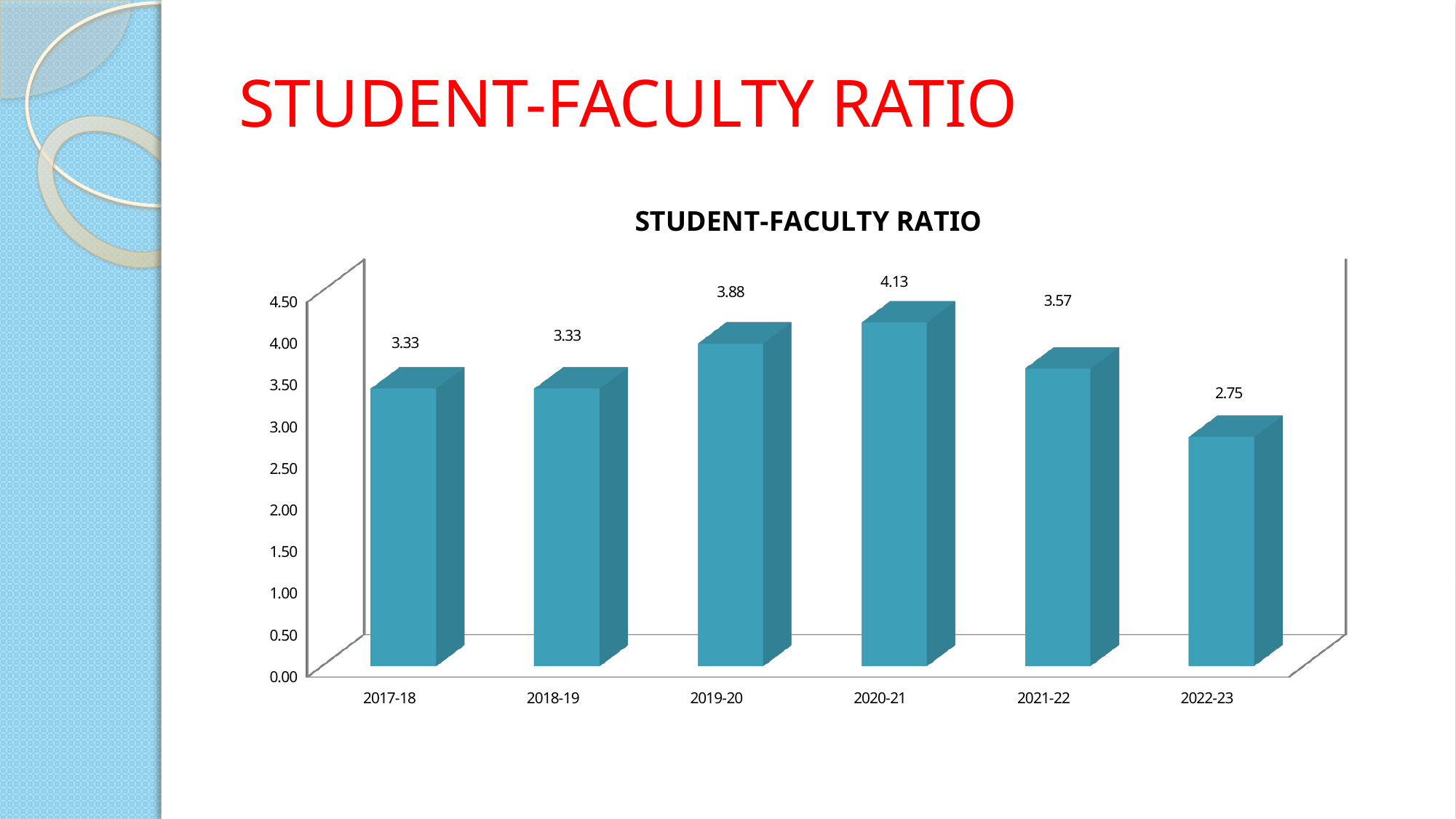
What is the student-faculty ratio for 2022-23? 2.75 What is the title of the chart? STUDENT-FACULTY RATIO What is the student-faculty ratio for 2021-22? 3.57 Which year has the lowest student-faculty ratio? 2022-23 What is the difference between the student-faculty ratio in 2019-20 and in 2021-22? 0.31 Is the student-faculty ratio for 2020-21 greater or less than 4.00? greater Which is larger, the student-faculty ratio for 2019-20 or for 2021-22? 2019-20 What kind of chart is shown on the slide? bar chart How many academic years are shown on the chart? 6 What is the student-faculty ratio for 2019-20? 3.88 What is the difference between the student-faculty ratio in 2020-21 and in 2022-23? 1.38 Which year has the highest student-faculty ratio? 2020-21